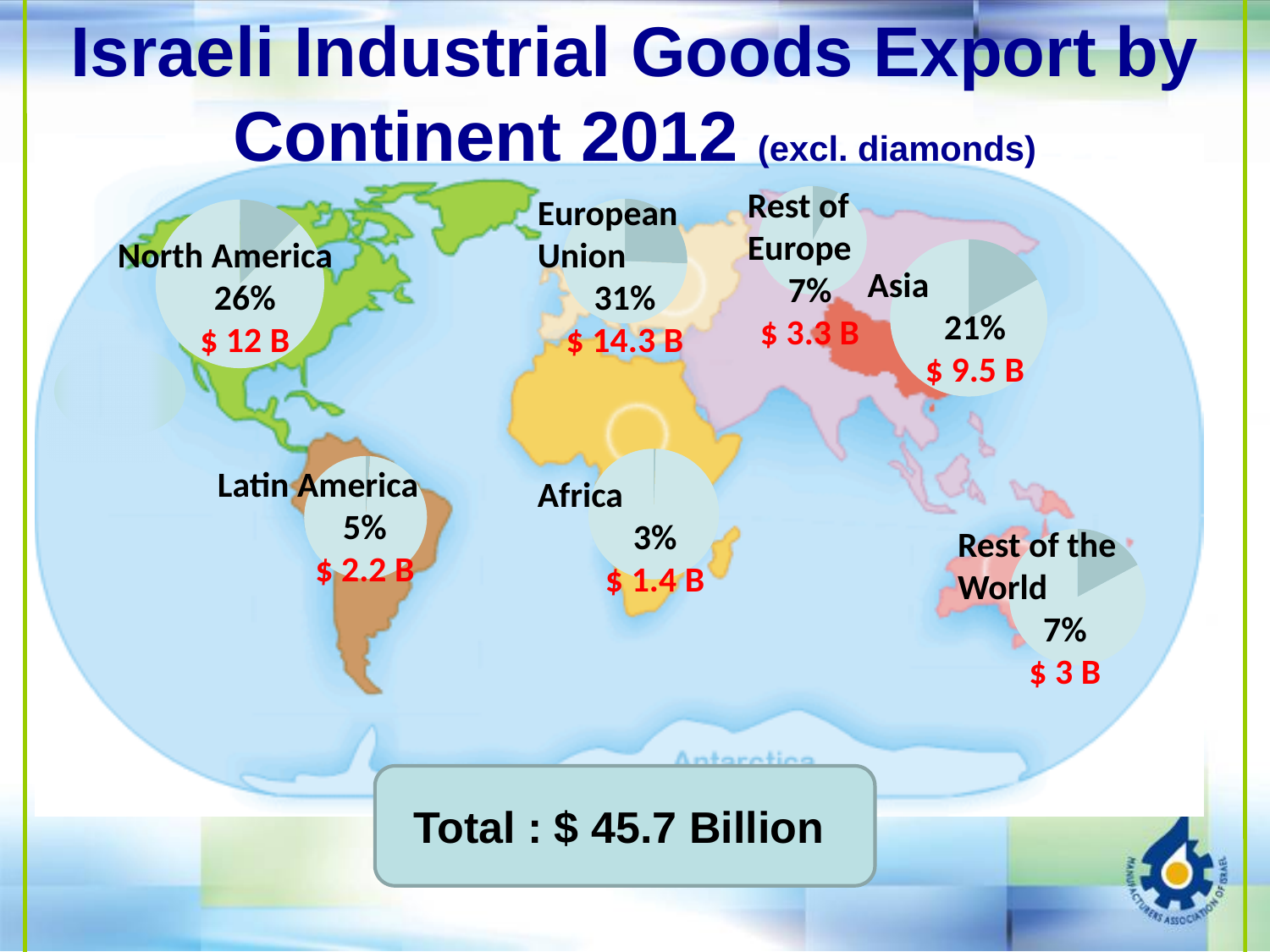
How many regions are shown with their own pie chart on the map? 7 Which region received the smallest share of exports? Africa What share of Israeli industrial goods exports in 2012 went to the European Union? 31% What kind of chart is used for each region on the map? Pie chart What was the dollar value of exports to Asia? $ 9.5 B What percentage of exports went to Africa? 3% What was the dollar value of exports to North America? $ 12 B Which region received the largest share of Israeli industrial goods exports in 2012? European Union What is the difference in export value between the European Union and North America? $ 2.3 B Which received more exports by value, Rest of Europe or Rest of the World? Rest of Europe What is the total value of Israeli industrial goods exports shown on the slide? $ 45.7 Billion What does the slide title say is excluded from the export figures? Diamonds